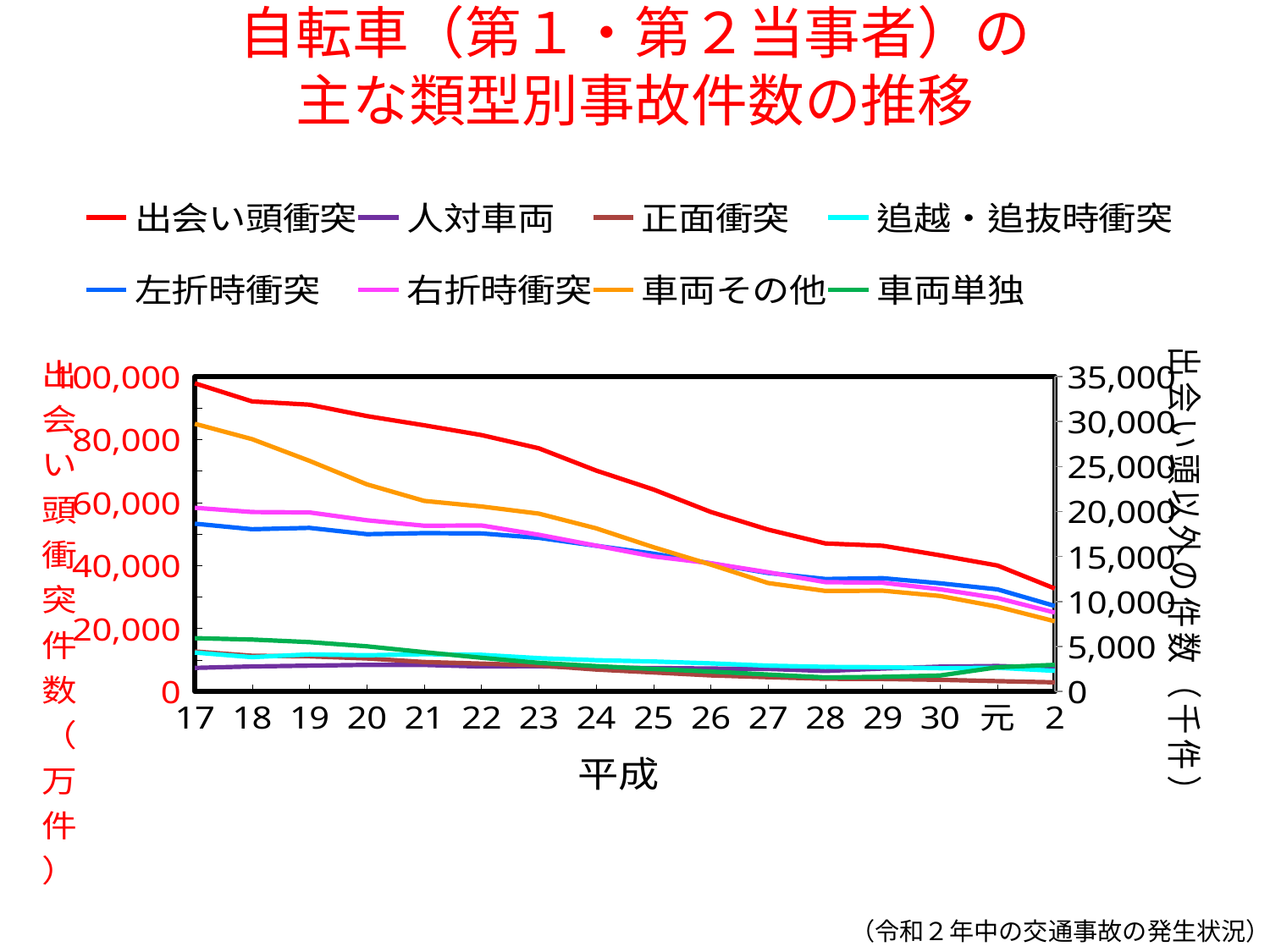
Is the value for 車両その他 at 2 greater or less than 10,000 on the right axis? less Does the 車両その他 line rise or fall from 17 to 2 along the x axis? fall At 17, which is larger, 車両その他 or 右折時衝突? 車両その他 Does the 出会い頭衝突 line rise or fall from 17 to 2 along the x axis? fall How many points are plotted along the x axis? 16 At 17, which is larger, 車両単独 or 人対車両? 車両単独 What kind of chart is shown on the slide? line chart Is the value for 出会い頭衝突 at 17 greater or less than 80,000 on the left axis? greater Is the value for 車両その他 at 17 greater or less than 25,000 on the right axis? greater What colour is the 出会い頭衝突 line in the legend? red How many series does the legend list? 8